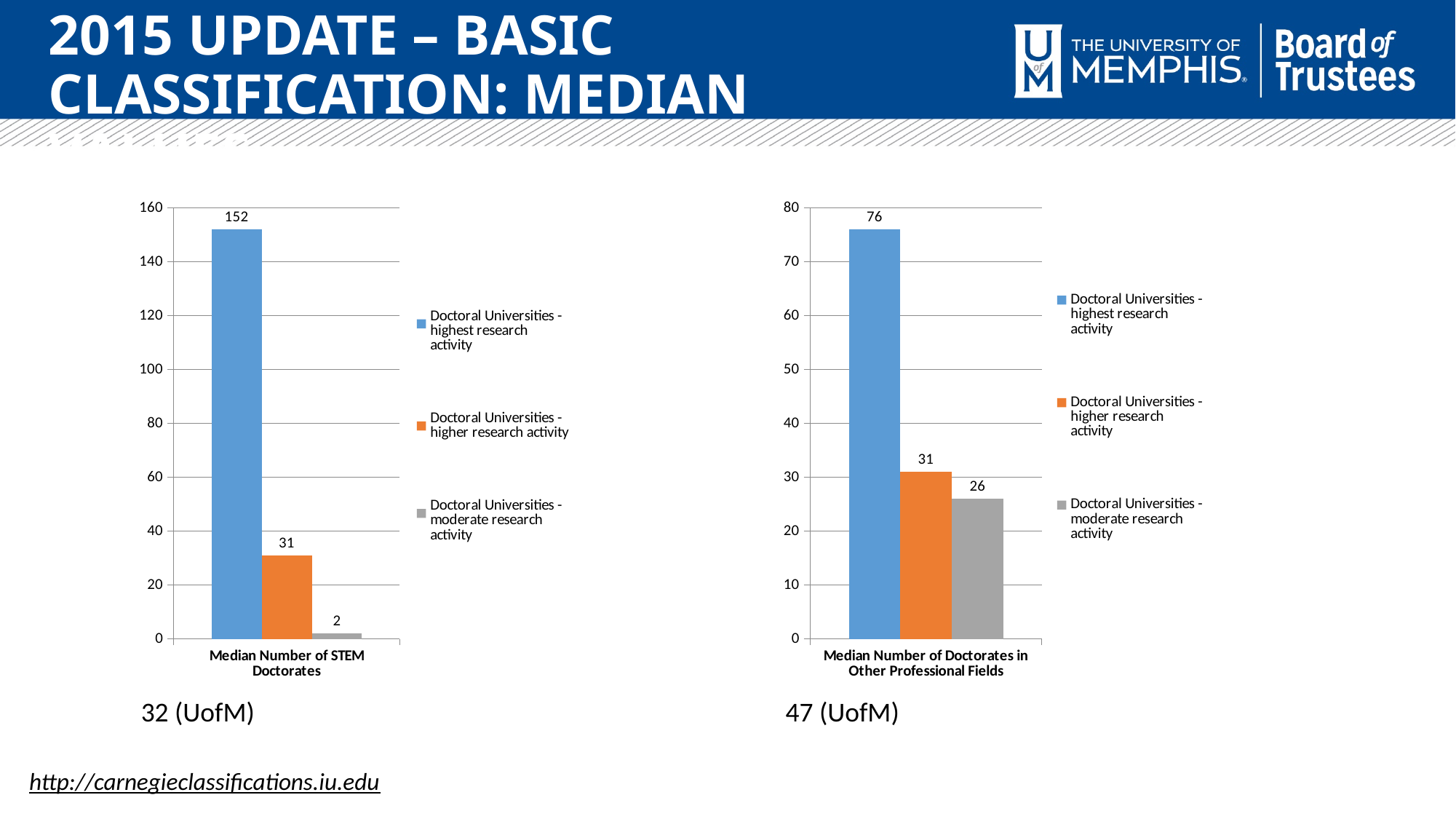
In the right chart (Median Number of Doctorates in Other Professional Fields), which is larger: the value for higher research activity or the value for moderate research activity? higher research activity In the left chart (Median Number of STEM Doctorates), what is the value for Doctoral Universities - highest research activity? 152 What kind of chart is the left chart (Median Number of STEM Doctorates)? bar chart In the left chart (Median Number of STEM Doctorates), what is the difference between the highest research activity value and the higher research activity value? 121 In the right chart (Median Number of Doctorates in Other Professional Fields), which series has the lowest value? Doctoral Universities - moderate research activity How many series does the legend of the right chart (Median Number of Doctorates in Other Professional Fields) list? 3 In the left chart (Median Number of STEM Doctorates), which series has the highest value? Doctoral Universities - highest research activity In the right chart (Median Number of Doctorates in Other Professional Fields), what is the value for Doctoral Universities - moderate research activity? 26 In the left chart (Median Number of STEM Doctorates), what is the value for Doctoral Universities - moderate research activity? 2 In the right chart (Median Number of Doctorates in Other Professional Fields), what is the difference between the highest research activity value and the moderate research activity value? 50 In the left chart (Median Number of STEM Doctorates), is the value for Doctoral Universities - highest research activity greater or less than 140? greater In the right chart (Median Number of Doctorates in Other Professional Fields), what is the value for Doctoral Universities - higher research activity? 31